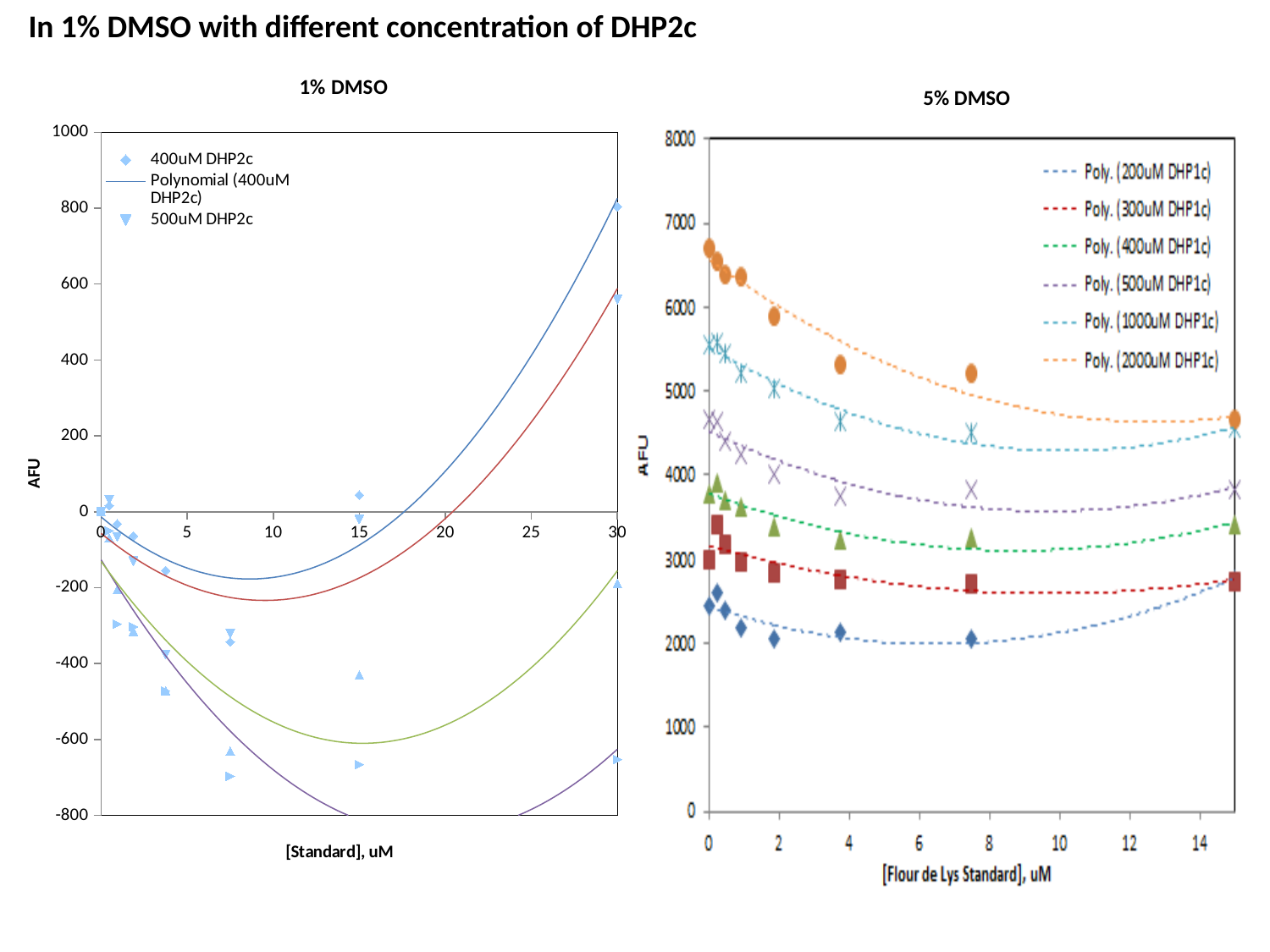
In the 5% DMSO chart, do the AFU values of the 2000uM DHP1c series rise or fall between 0 and 8 uM? fall In the 5% DMSO chart, is the AFU value of the 200uM DHP1c series at about 7.5 uM greater or less than 3000? less In the 5% DMSO chart, is the AFU value of the 2000uM DHP1c series at 0 uM greater or less than 6000? greater What is the x-axis label of the 5% DMSO chart? [Flour de Lys Standard], uM How many series does the legend of the 5% DMSO chart list? 6 In the 5% DMSO chart, which series has higher AFU values, 2000uM DHP1c or 200uM DHP1c? 2000uM DHP1c How many entries does the legend of the 1% DMSO chart list? 3 What kind of chart is the 1% DMSO chart on the left? scatter chart In the 5% DMSO chart, which series has the lowest AFU values? 200uM DHP1c What is the title of the chart on the right? 5% DMSO What kind of chart is the 5% DMSO chart on the right? scatter chart In the 1% DMSO chart, is the 400uM DHP2c value at 30 uM greater or less than 600? greater